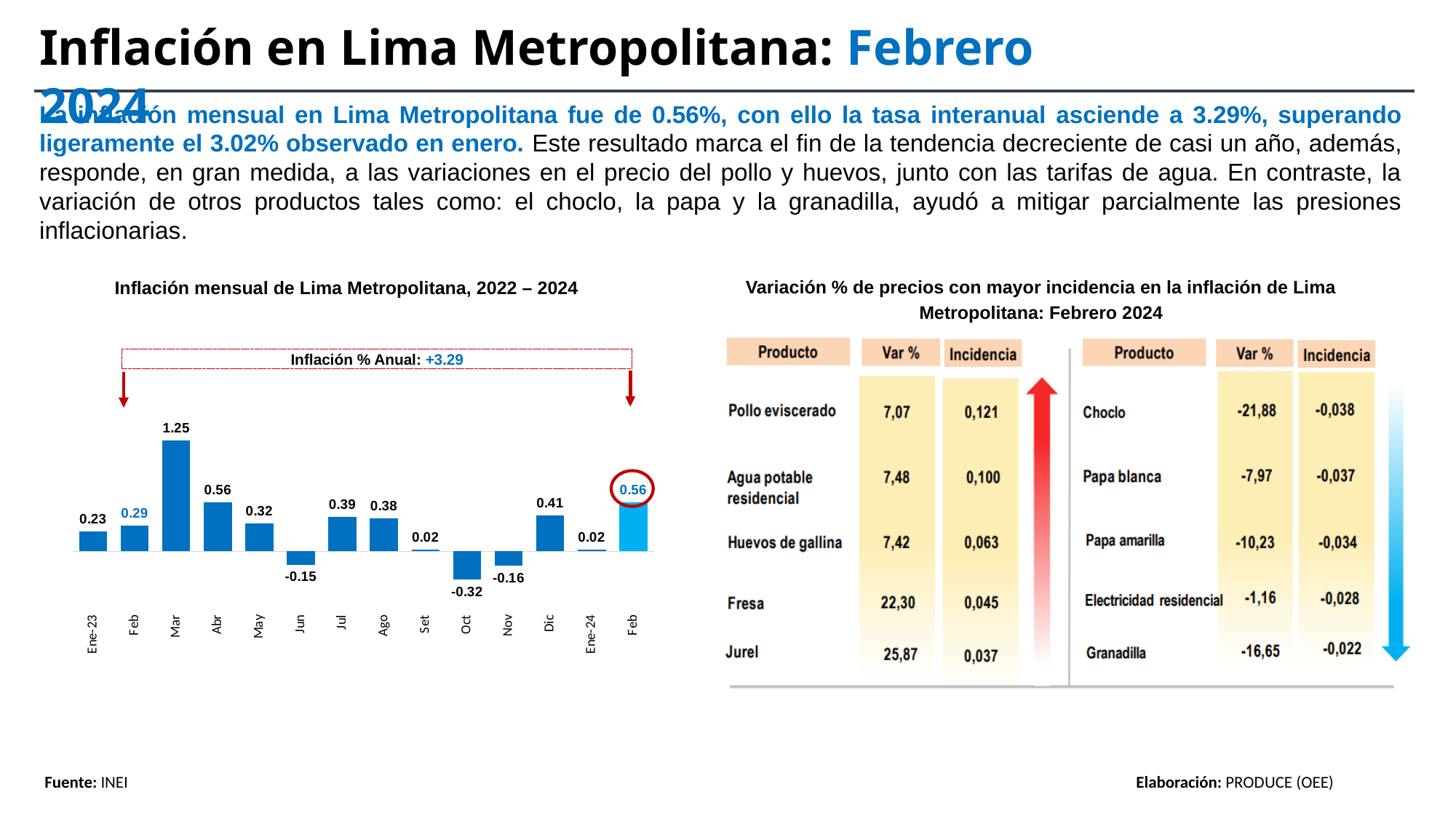
In the chart 'Inflación mensual de Lima Metropolitana, 2022 – 2024', which month has the lowest value? Oct In the chart 'Inflación mensual de Lima Metropolitana, 2022 – 2024', what is the value for Ene-24? 0.02 In the chart 'Inflación mensual de Lima Metropolitana, 2022 – 2024', which is larger, the value for Dic or the value for Jul? Dic In the chart 'Inflación mensual de Lima Metropolitana, 2022 – 2024', what is the value for Mar? 1.25 In the chart 'Inflación mensual de Lima Metropolitana, 2022 – 2024', what is the value for the last bar, Feb (2024)? 0.56 In the chart 'Inflación mensual de Lima Metropolitana, 2022 – 2024', what is the difference between the values for Mar and Abr? 0.69 In the chart 'Inflación mensual de Lima Metropolitana, 2022 – 2024', do the values rise or fall from Ene-24 to Feb? Rise In the chart 'Inflación mensual de Lima Metropolitana, 2022 – 2024', what is the value for Oct? -0.32 What annual inflation figure is shown in the label above the chart 'Inflación mensual de Lima Metropolitana, 2022 – 2024'? +3.29 How many monthly bars are plotted in the chart 'Inflación mensual de Lima Metropolitana, 2022 – 2024'? 14 In the chart 'Inflación mensual de Lima Metropolitana, 2022 – 2024', which month has the highest value? Mar What kind of chart is 'Inflación mensual de Lima Metropolitana, 2022 – 2024'? Bar chart